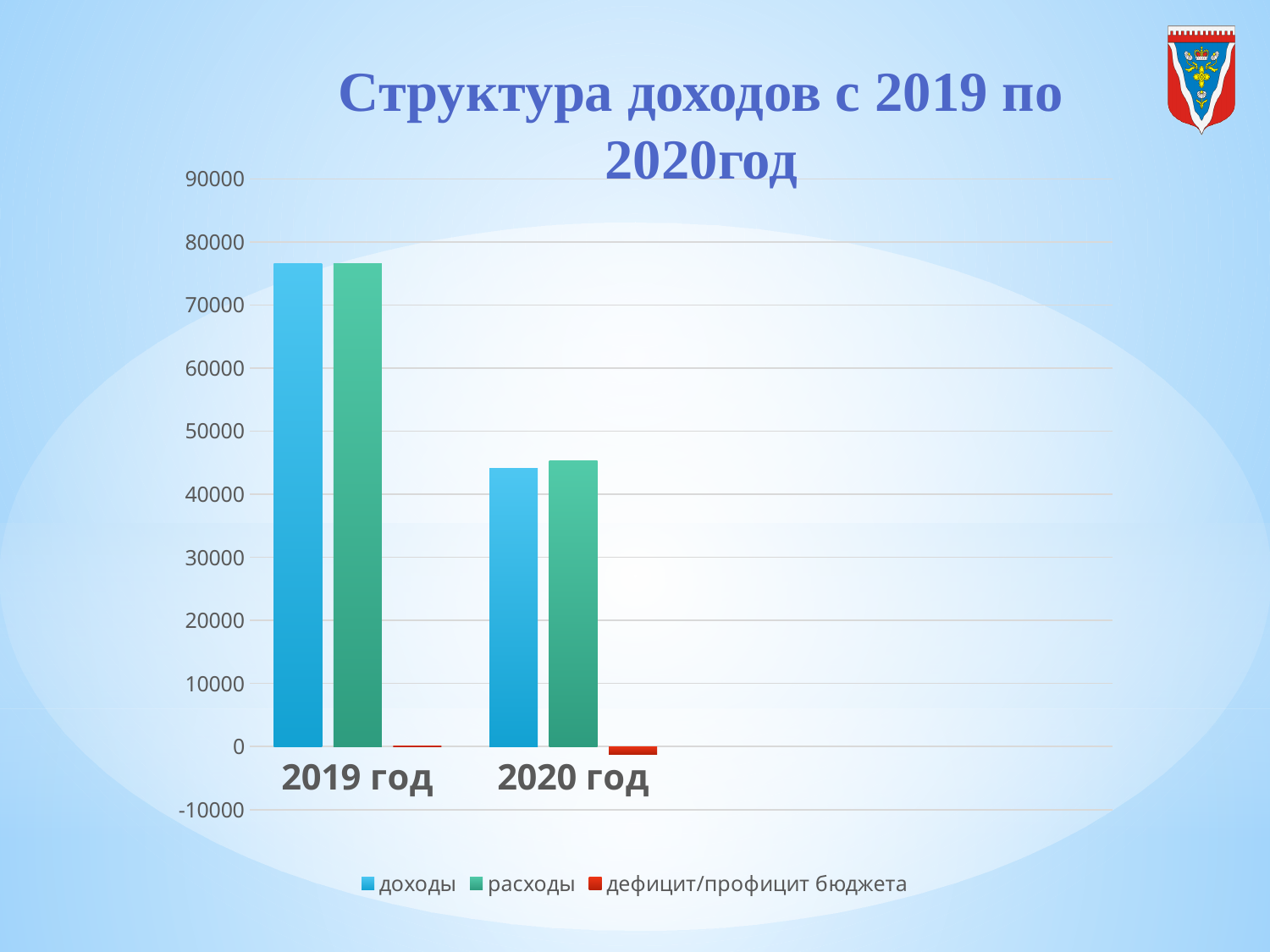
Is the value for доходы in 2020 год greater or less than 50000? less Is the value for дефицит/профицит бюджета in 2020 год greater or less than 0? less What is the title of the chart? Структура доходов с 2019 по 2020год Which series is shown in red in the legend? дефицит/профицит бюджета In which year is расходы highest? 2019 год What kind of chart is shown on the slide? bar chart How many categories are shown on the x axis? 2 Do the values for доходы rise or fall from 2019 год to 2020 год? fall Is the value for расходы in 2020 год greater or less than 40000? greater Which is larger, доходы in 2019 год or доходы in 2020 год? 2019 год How many series does the legend list? 3